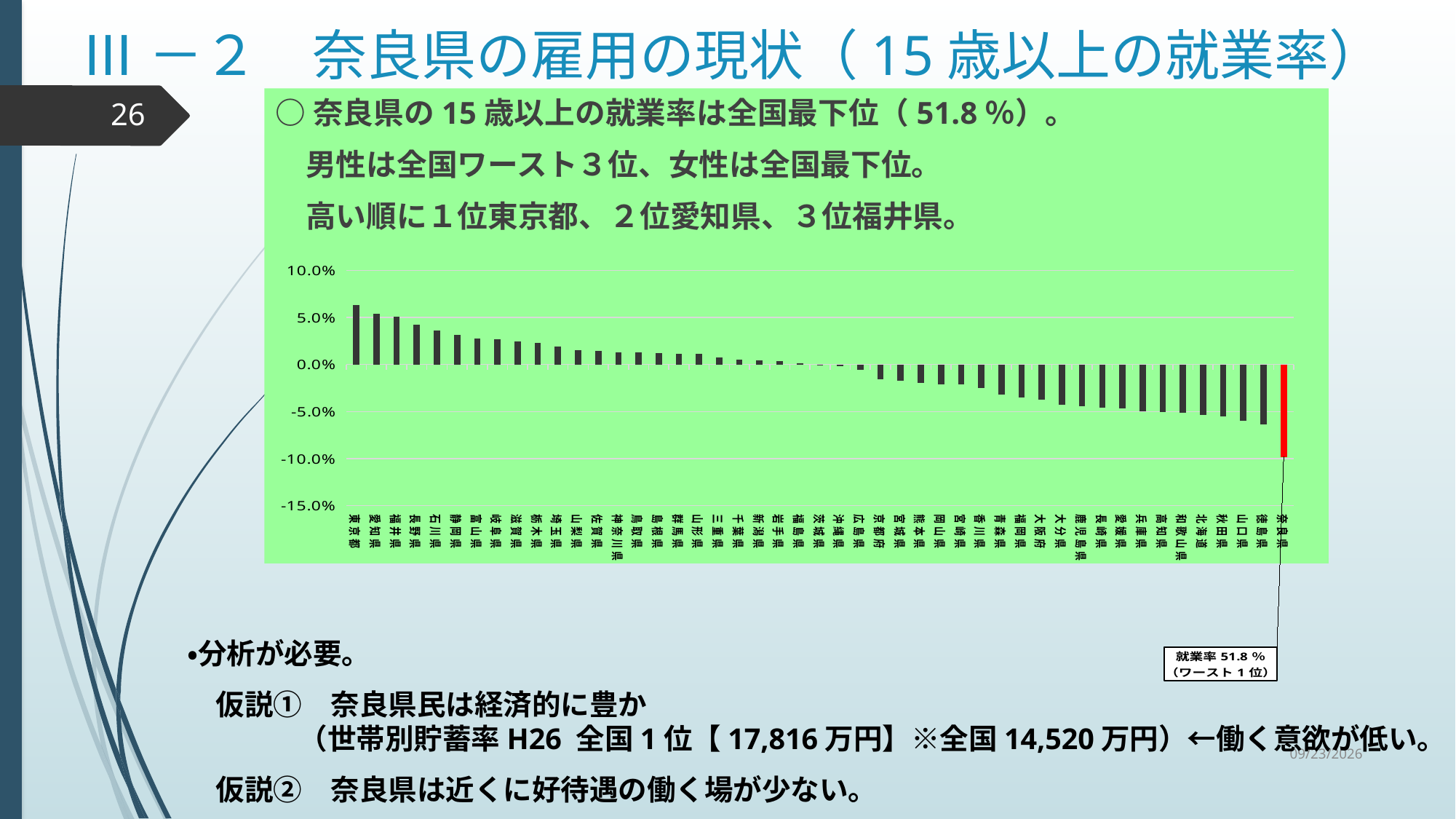
Which has the larger value, 東京都 or 愛知県? 東京都 Which prefecture's bar is highlighted in red? 奈良県 Which has the larger value, 奈良県 or 徳島県? 徳島県 Which prefecture has the highest bar in the chart? 東京都 How many prefectures (categories) are plotted in the chart? 47 Is the value for 奈良県 greater or less than -5.0%? less Is the value for 徳島県 greater or less than 0.0%? less What kind of chart is shown on the slide? bar chart According to the annotation on the chart, what is the employment rate (就業率) for 奈良県? 51.8% Do the bar values rise or fall moving from left to right along the x axis? fall Which prefecture has the lowest bar in the chart? 奈良県 Is the value for 東京都 greater or less than 5.0%? greater